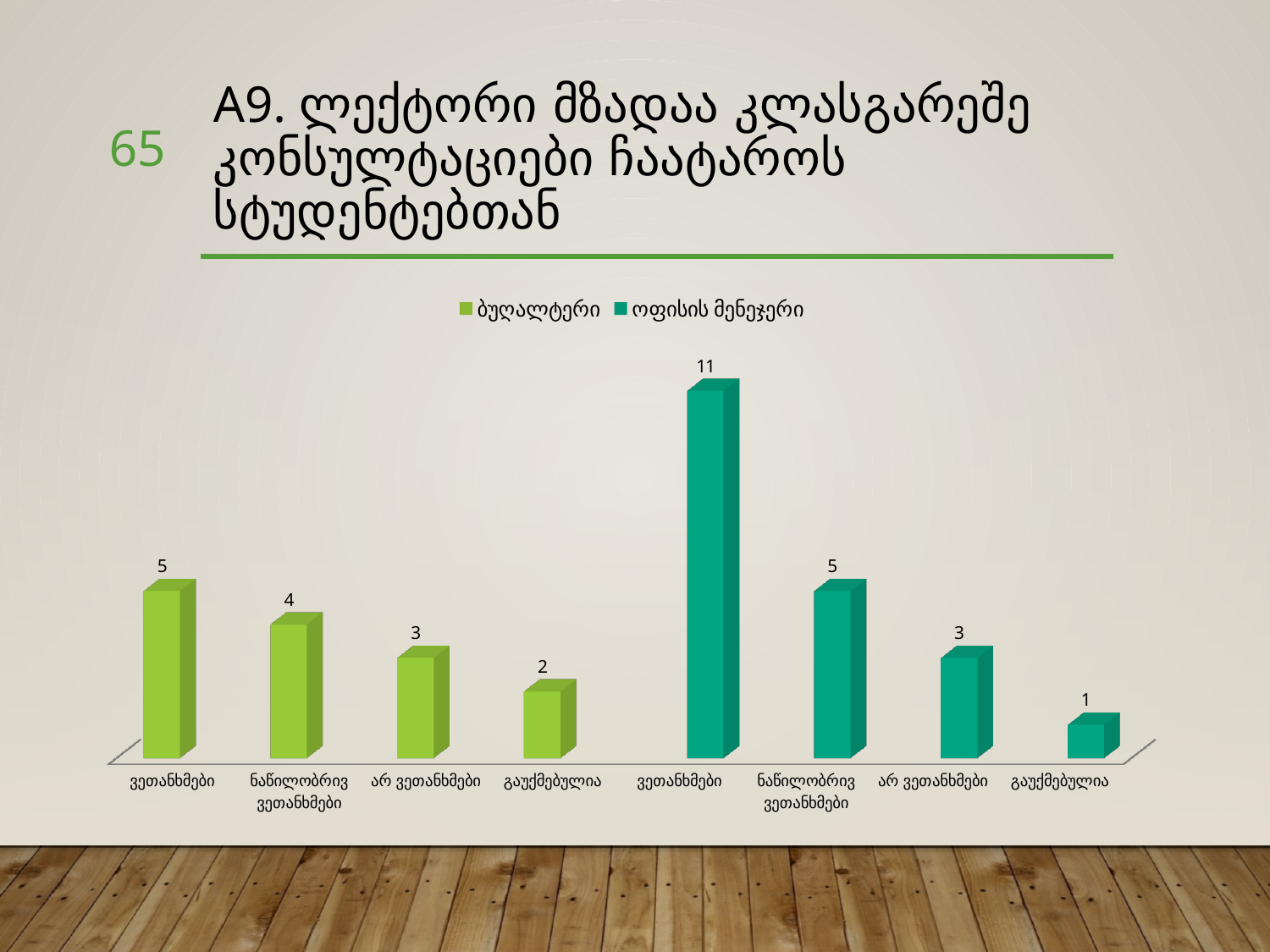
Do the values in the ბუღალტერი series rise or fall from ვეთანხმები to გაუქმებულია? Fall What is the difference between the ოფისის მენეჯერი and ბუღალტერი values for ვეთანხმები? 6 How many categories are shown for each series? 4 How many series does the legend list? 2 Which is larger: the ბუღალტერი value for ნაწილობრივ ვეთანხმები or the ოფისის მენეჯერი value for ნაწილობრივ ვეთანხმები? ოფისის მენეჯერი What is the value for ვეთანხმები in the ოფისის მენეჯერი series? 11 What is the value for გაუქმებულია in the ოფისის მენეჯერი series? 1 What kind of chart is shown on the slide? Bar chart Which category has the highest value in the ოფისის მენეჯერი series? ვეთანხმები What is the value for ნაწილობრივ ვეთანხმები in the ბუღალტერი series? 4 What is the value for არ ვეთანხმები in the ბუღალტერი series? 3 Which category has the lowest value in the ბუღალტერი series? გაუქმებულია